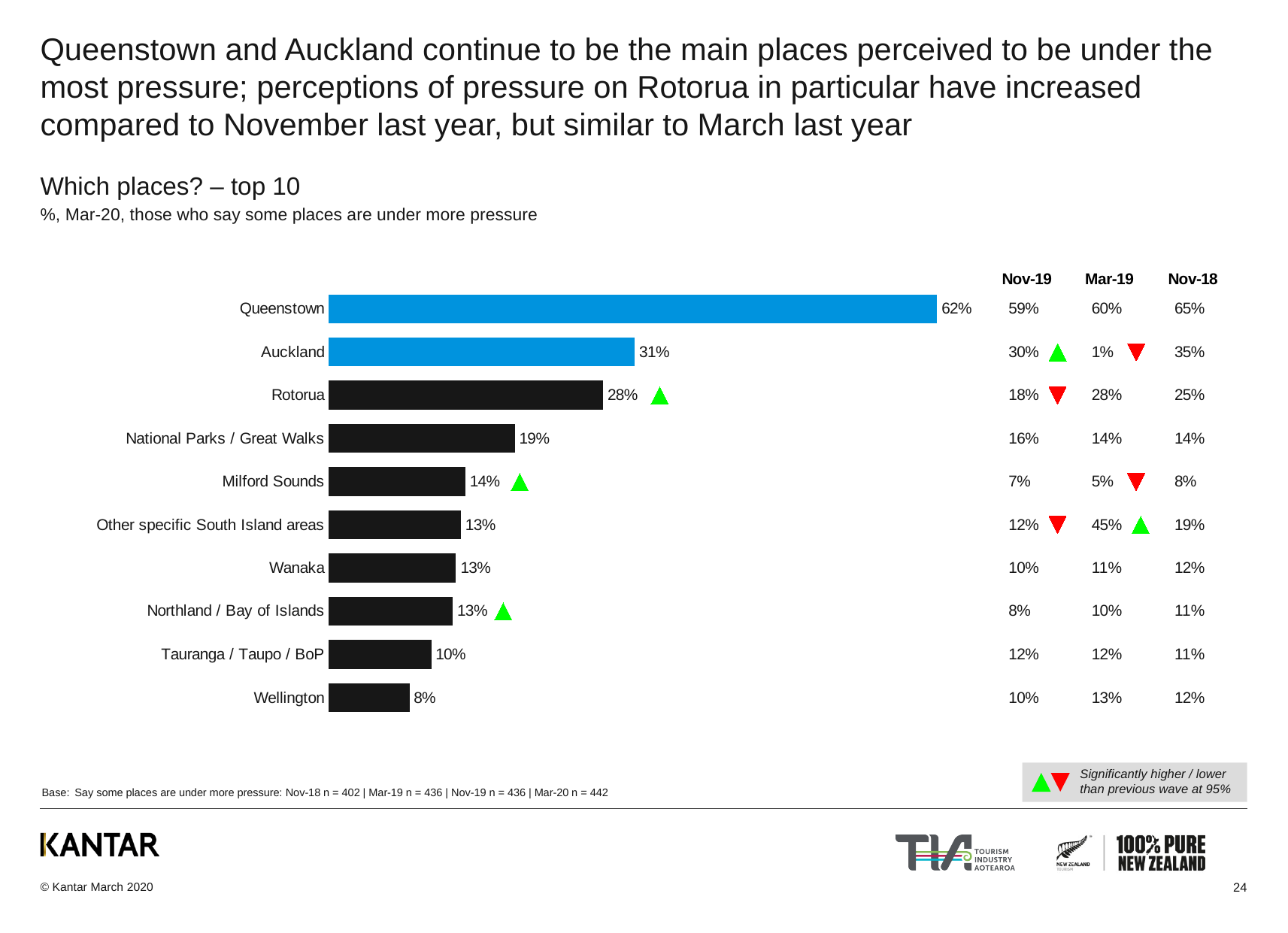
What is the difference between the values for Milford Sounds and Wellington? 6% Which place has the lowest value? Wellington Which is larger, the value for Auckland or the value for Rotorua? Auckland What is the value for National Parks / Great Walks? 19% Which two bars are coloured blue rather than black? Queenstown and Auckland What is the value for Rotorua? 28% How many places are shown in the chart? 10 What is the difference between the values for Queenstown and Auckland? 31% Which place has the highest value? Queenstown What kind of chart is shown on the slide? Bar chart What is the value for Tauranga / Taupo / BoP? 10% What is the value for Queenstown? 62%